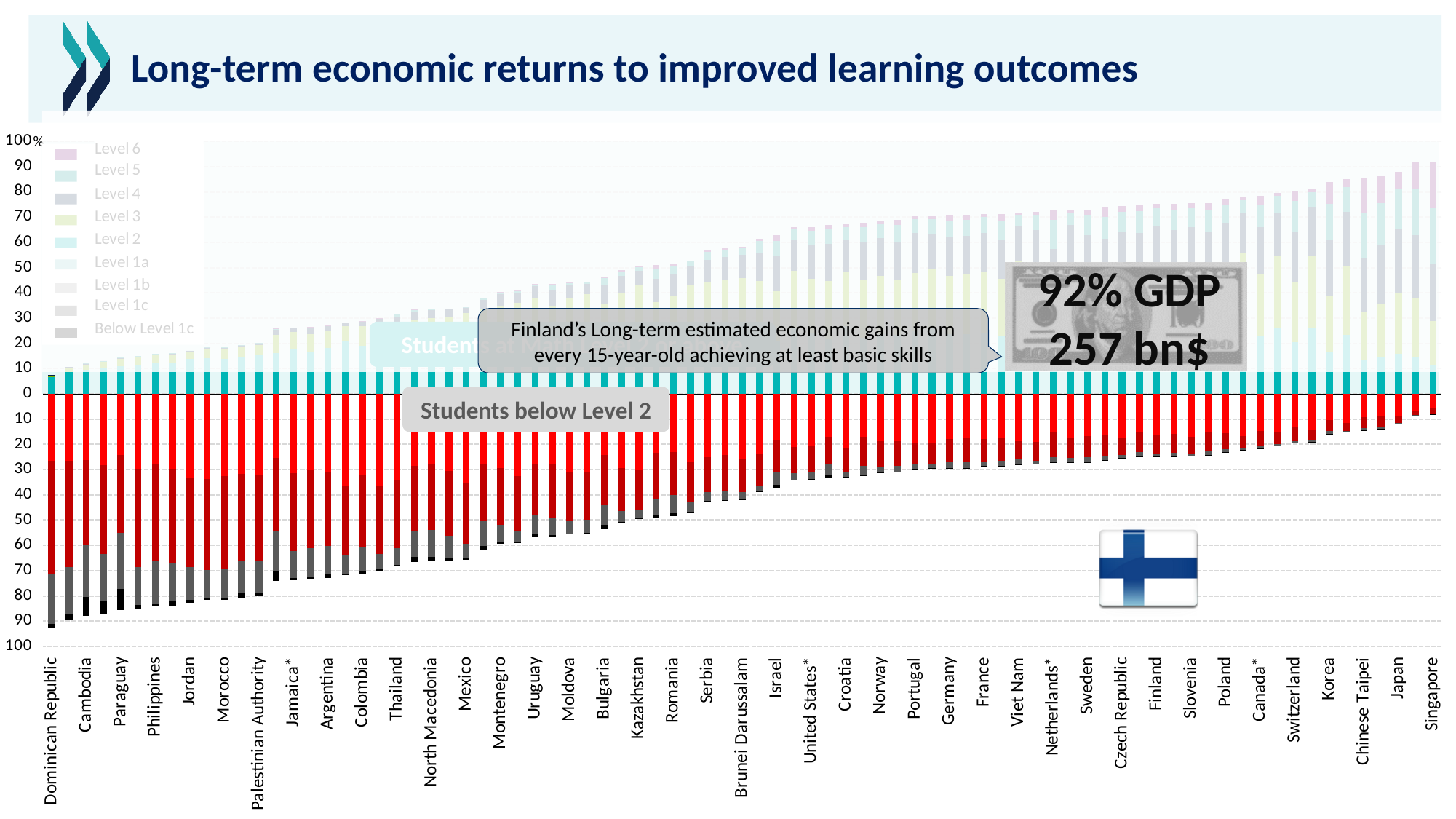
Which has a larger share of students at Level 2 or above, Singapore or the Dominican Republic? Singapore What kind of chart is shown on the slide? stacked bar chart Is the share of students below Level 2 for the Dominican Republic greater or less than 80? greater Is the share of students at Level 2 or above for Singapore greater or less than 80? greater Which country is shown at the far right of the x axis? Singapore What is the title of the slide? Long-term economic returns to improved learning outcomes Which country is shown at the far left of the x axis? Dominican Republic According to the callout on the chart, what is Finland's long-term estimated economic gain from every 15-year-old achieving at least basic skills, as a share of GDP? 92% GDP Moving from left to right along the x axis, does the share of students at Level 2 or above rise or fall? rise How many entries does the chart legend list? 9 Is the share of students below Level 2 for Singapore greater or less than 20? less